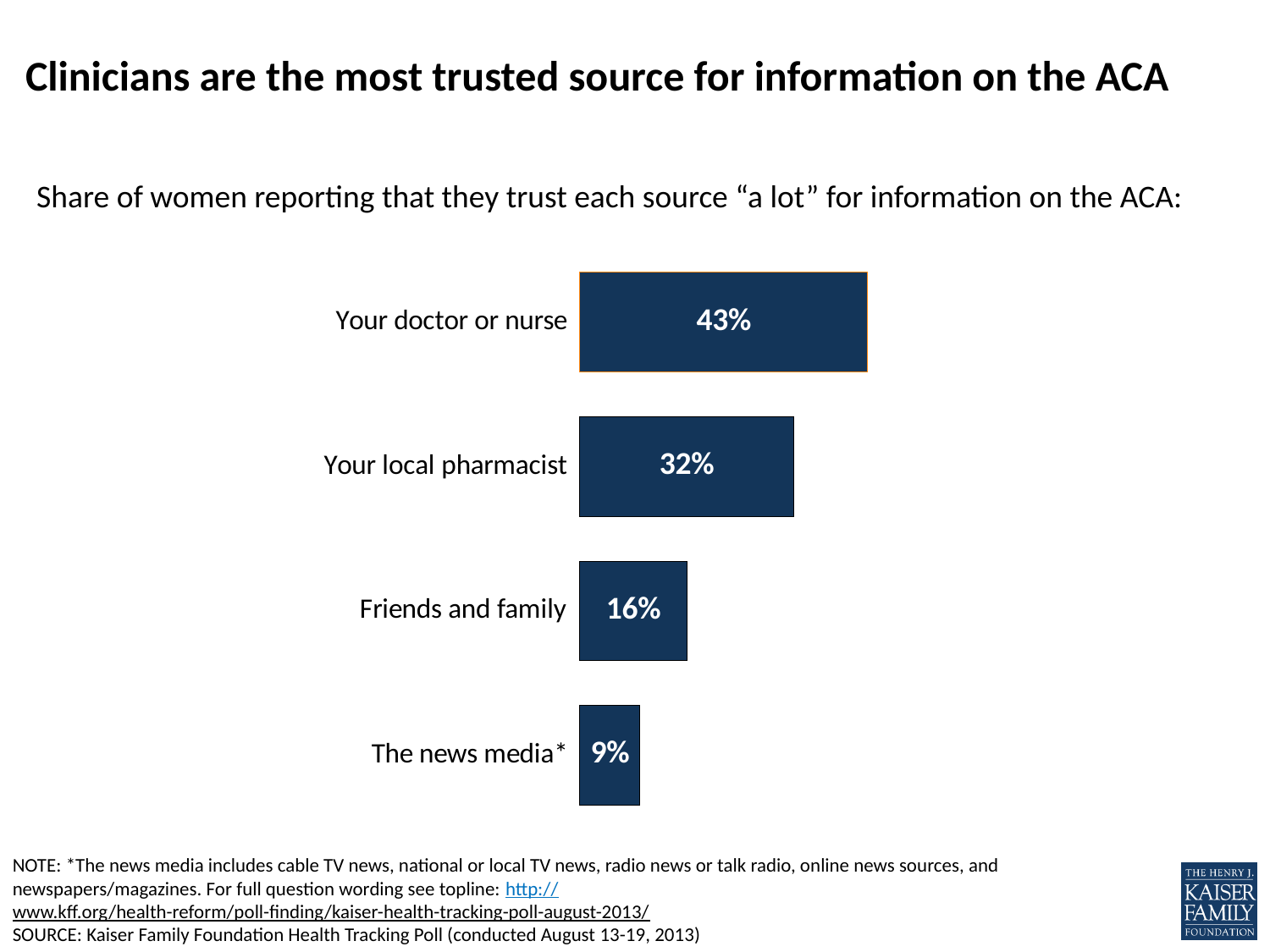
What share of women trust their doctor or nurse "a lot" for information on the ACA? 43% What share of women trust friends and family "a lot" for information on the ACA? 16% What share of women trust their local pharmacist "a lot" for information on the ACA? 32% What is the difference in percentage points between the share for "Your doctor or nurse" and the share for "Your local pharmacist"? 11 percentage points What is the difference in percentage points between the share for "Friends and family" and the share for "The news media*"? 7 percentage points Which has a larger share: "Your local pharmacist" or "Friends and family"? Your local pharmacist Which source has the lowest share of women trusting it "a lot"? The news media* What kind of chart is shown on the slide? Bar chart How many sources are shown in the chart? 4 What share of women trust the news media "a lot" for information on the ACA? 9% Which source has the highest share of women trusting it "a lot"? Your doctor or nurse What is the title of the slide? Clinicians are the most trusted source for information on the ACA